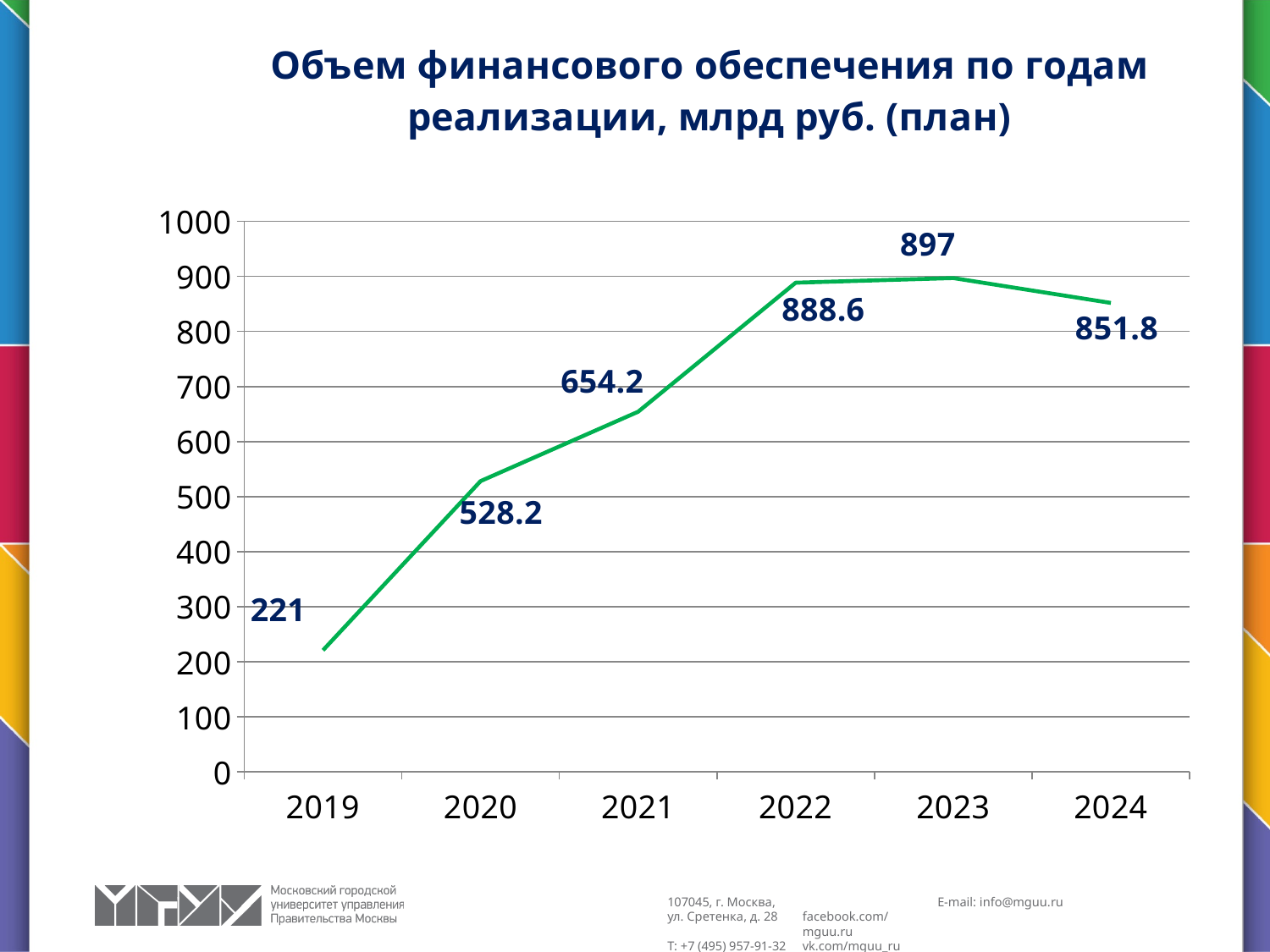
What is the value for 2019? 221 Do the values rise or fall from 2019 to 2023? rise What is the value for 2024? 851.8 Which is larger, the value for 2022 or the value for 2024? 2022 What is the difference between the values for 2023 and 2022? 8.4 What kind of chart is shown on the slide? line chart Which year has the lowest value? 2019 What is the difference between the values for 2020 and 2019? 307.2 How many years are plotted on the chart? 6 What is the value for 2021? 654.2 Is the value for 2021 greater or less than 600? greater Which year has the highest value? 2023